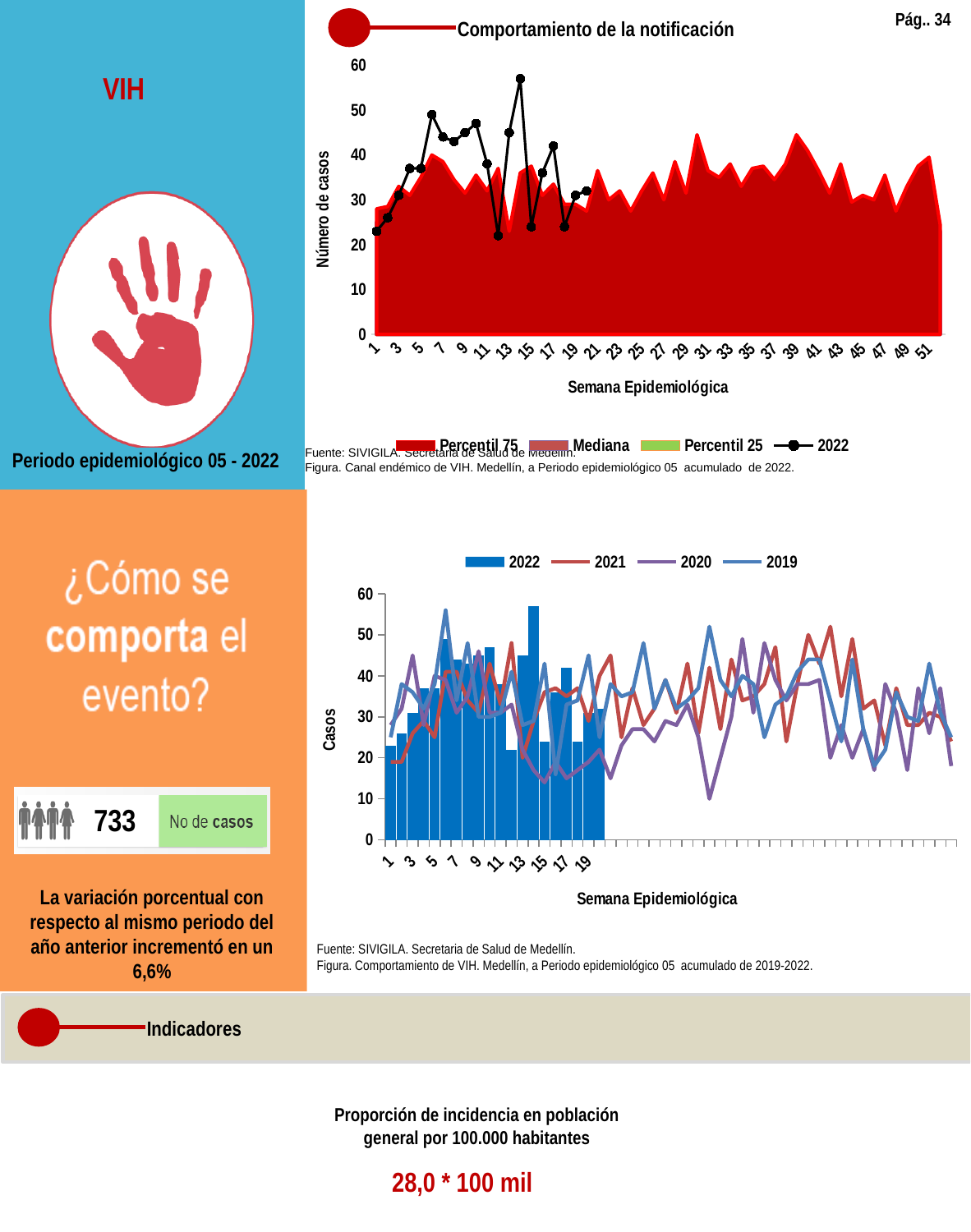
In the bottom chart (Comportamiento de VIH 2019-2022), which series is drawn as bars? 2022 In the bottom chart (Comportamiento de VIH 2019-2022), how many series does the legend list? 4 In the top chart titled "Comportamiento de la notificación", at which epidemiological week does the 2022 line reach its highest value? 14 In the top chart titled "Comportamiento de la notificación", does the 2022 line rise or fall from week 1 to week 6? rise In the bottom chart (Comportamiento de VIH 2019-2022), how many 2022 bars are plotted? 20 In the top chart titled "Comportamiento de la notificación", how many entries does the legend list? 4 In the bottom chart (Comportamiento de VIH 2019-2022), which 2022 bar is larger, week 14 or week 15? week 14 In the top chart titled "Comportamiento de la notificación", is the 2022 value at week 1 greater or less than 30? less In the top chart titled "Comportamiento de la notificación", is the 2022 value at week 14 greater or less than 50? greater In the top chart titled "Comportamiento de la notificación", what is the label of the y axis? Número de casos In the bottom chart (Comportamiento de VIH 2019-2022), is the 2022 bar for week 14 greater or less than 50? greater In the top chart titled "Comportamiento de la notificación", what are the legend entries? Percentil 75, Mediana, Percentil 25, 2022